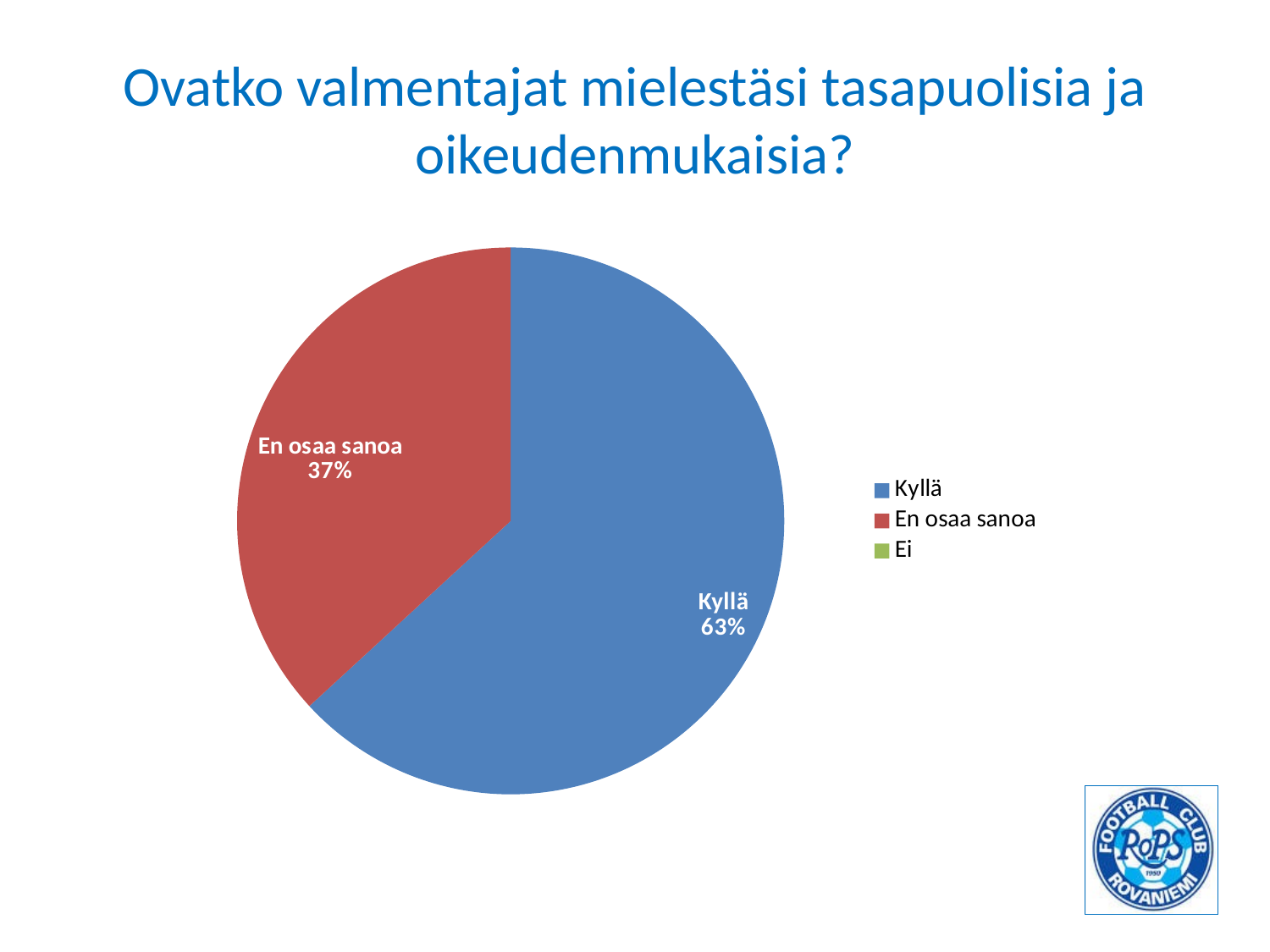
What colour is the Kyllä slice? blue What is the difference in percentage points between the Kyllä and En osaa sanoa slices? 26 percentage points What share of the pie does Kyllä have? 63% How many slices are visible in the pie? 2 Which category has the largest slice of the pie? Kyllä What kind of chart is shown on the slide? pie chart How many entries does the legend list? 3 Which is larger, the Kyllä slice or the En osaa sanoa slice? Kyllä What share of the pie does En osaa sanoa have? 37% Which of the two visible slices is smaller, Kyllä or En osaa sanoa? En osaa sanoa What is the title of the slide? Ovatko valmentajat mielestäsi tasapuolisia ja oikeudenmukaisia?